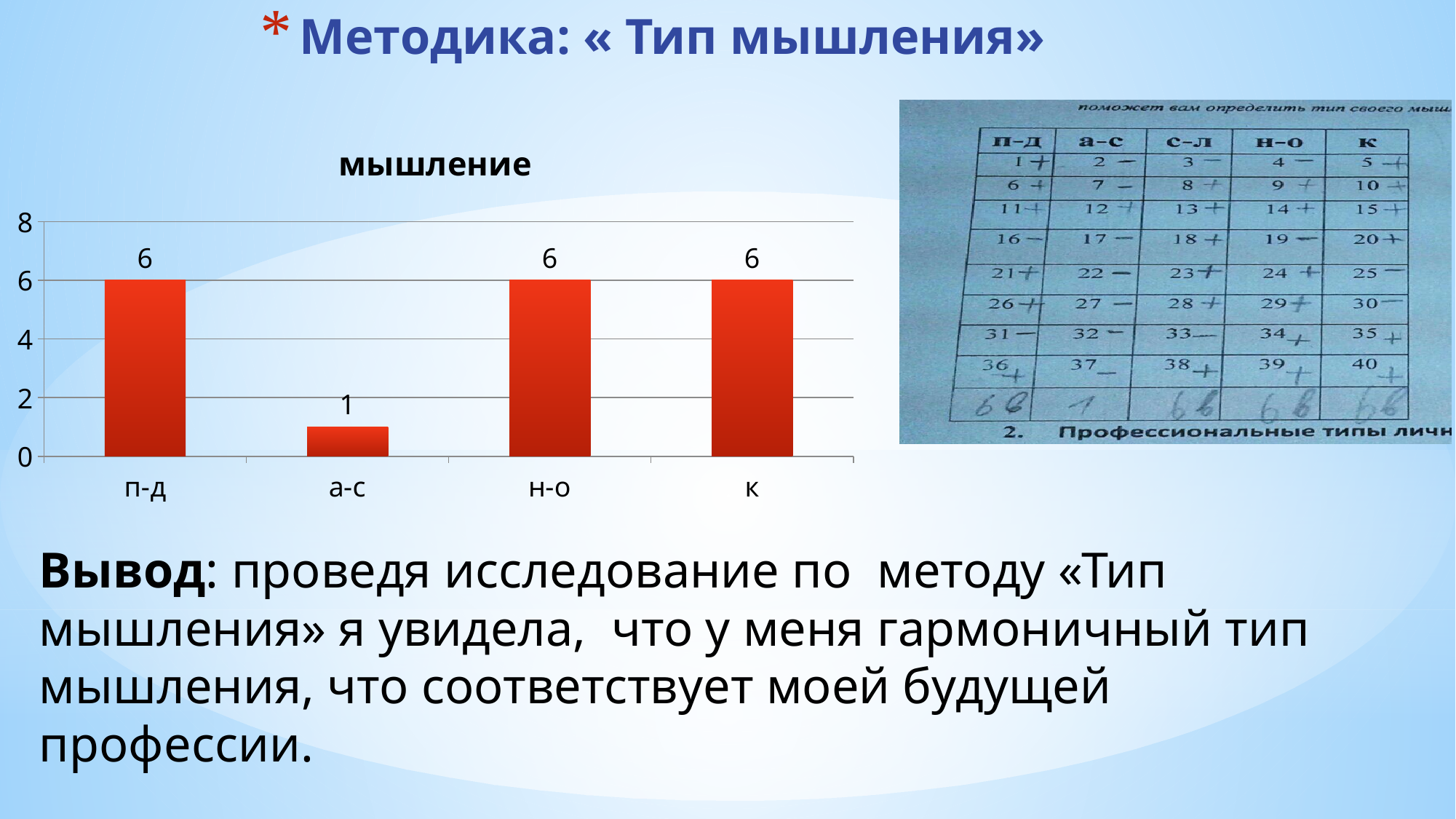
What is the difference between the values for п-д and а-с? 5 What kind of chart is shown on the slide? bar chart Is the value for н-о greater or less than 4? greater What is the value for а-с in the chart? 1 Which is larger, the value for а-с or the value for к? к Which category has the lowest value in the chart? а-с What is the value for п-д in the chart? 6 How many categories are shown in the chart? 4 What is the value for к in the chart? 6 Is the value for а-с greater or less than 2? less What is the title of the chart? мышление What is the value for н-о in the chart? 6